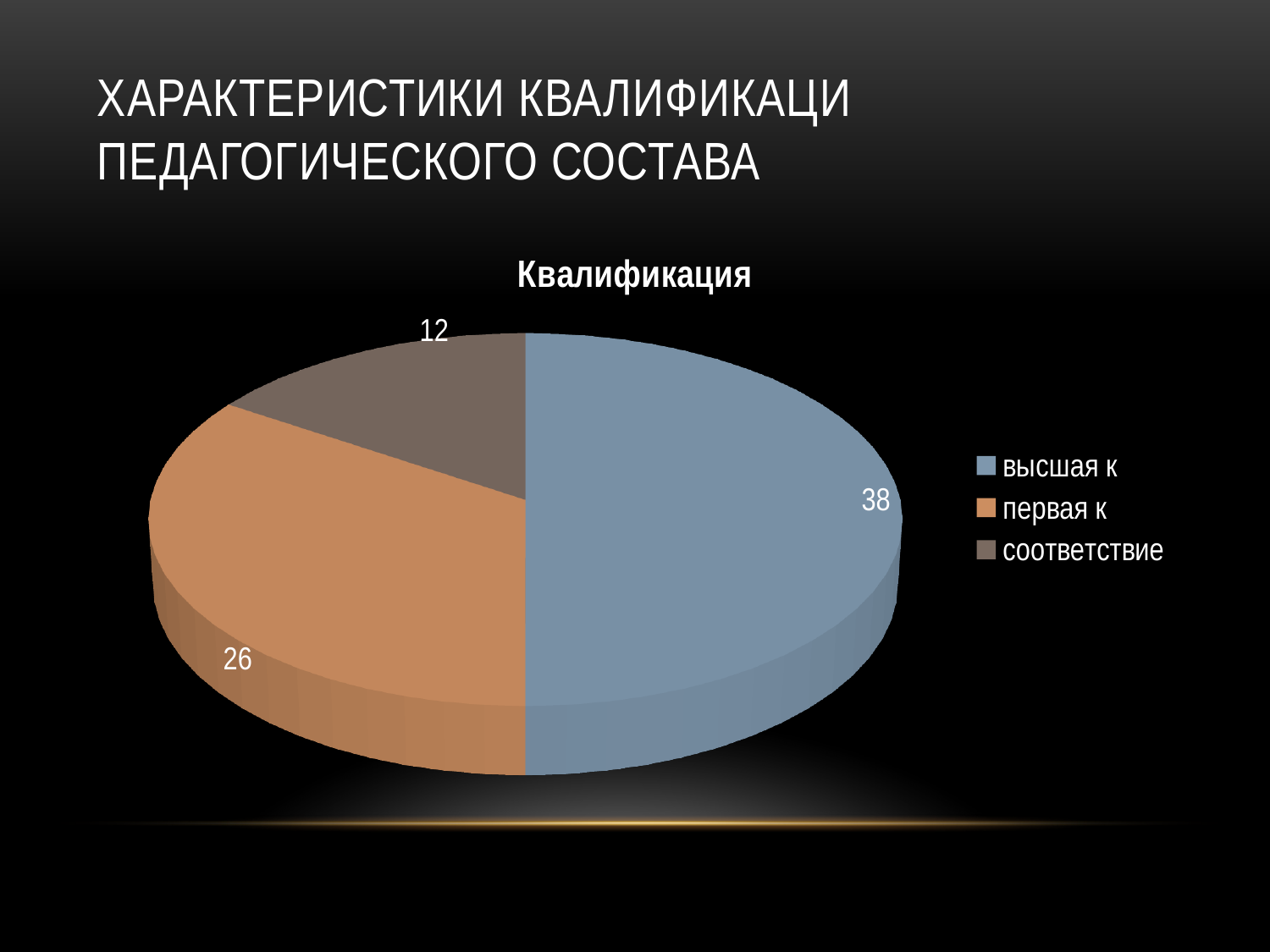
What share of the pie does высшая к represent? 50% What type of chart is shown on the slide? pie chart Which is larger, the value for первая к or the value for соответствие? первая к Which category has the smallest slice? соответствие How many categories does the legend list? 3 What is the title of the chart? Квалификация What is the value for высшая к? 38 What is the difference between the values for высшая к and первая к? 12 Which category has the largest slice? высшая к What is the value for соответствие? 12 What is the value for первая к? 26 What is the difference between the values for первая к and соответствие? 14